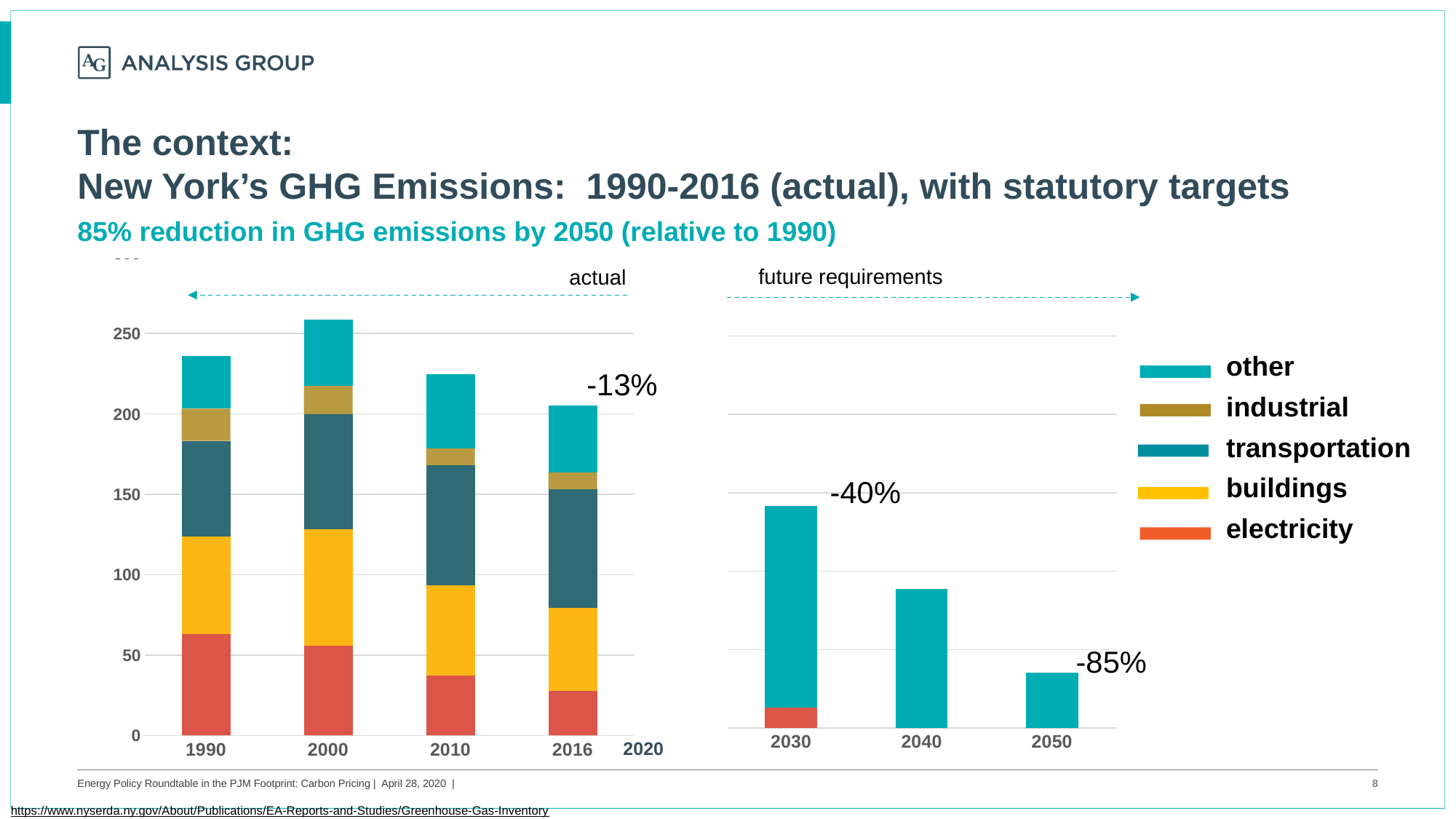
What percentage reduction is labelled on the 2030 bar? -40% What percentage change is labelled on the 2016 bar? -13% Is the total bar for 2000 greater or less than 250? greater Is the total bar for 2050 greater or less than 50? less Do the bars rise or fall from 2030 to 2050? fall Which year has the highest total emissions bar? 2000 Which year has the lowest total emissions bar? 2050 What kind of chart is shown on the slide? bar chart Which is larger, the total bar for 1990 or the total bar for 2016? 1990 What percentage reduction is labelled on the 2050 bar? -85% How many series does the legend list? 5